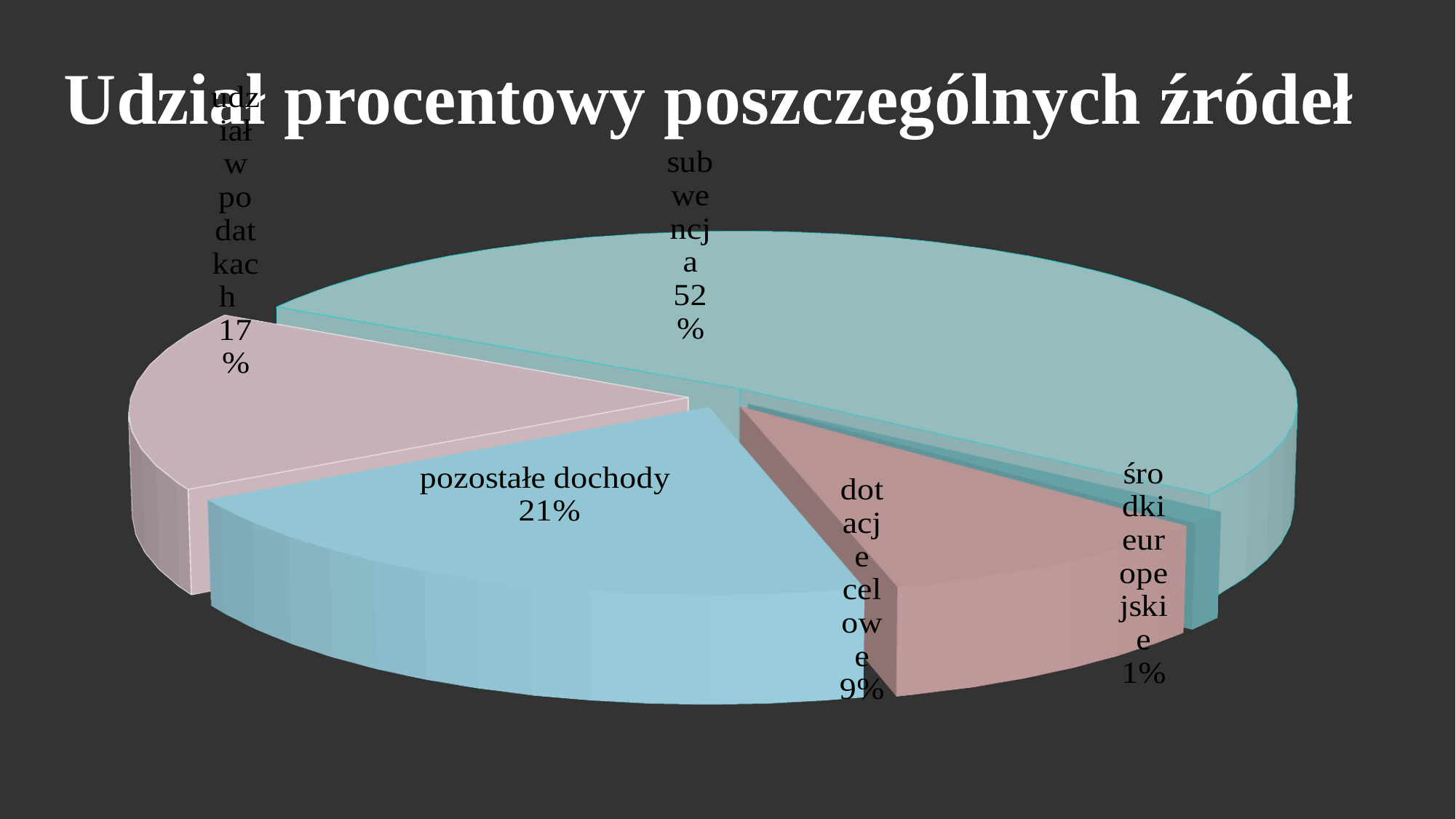
Which source has the largest share of the pie? subwencja How many slices does the pie chart have? 5 What share of the pie does subwencja have? 52% What is the title of the chart? Udział procentowy poszczególnych źródeł What is the difference in percentage points between subwencja and pozostałe dochody? 31 Which source has the smallest share of the pie? środki europejskie What percentage is shown for dotacje celowe? 9% What percentage is shown for środki europejskie? 1% What percentage is shown for pozostałe dochody? 21% Which is larger, the share for udział w podatkach or the share for dotacje celowe? udział w podatkach What percentage is shown for udział w podatkach? 17% What type of chart is shown on the slide? pie chart